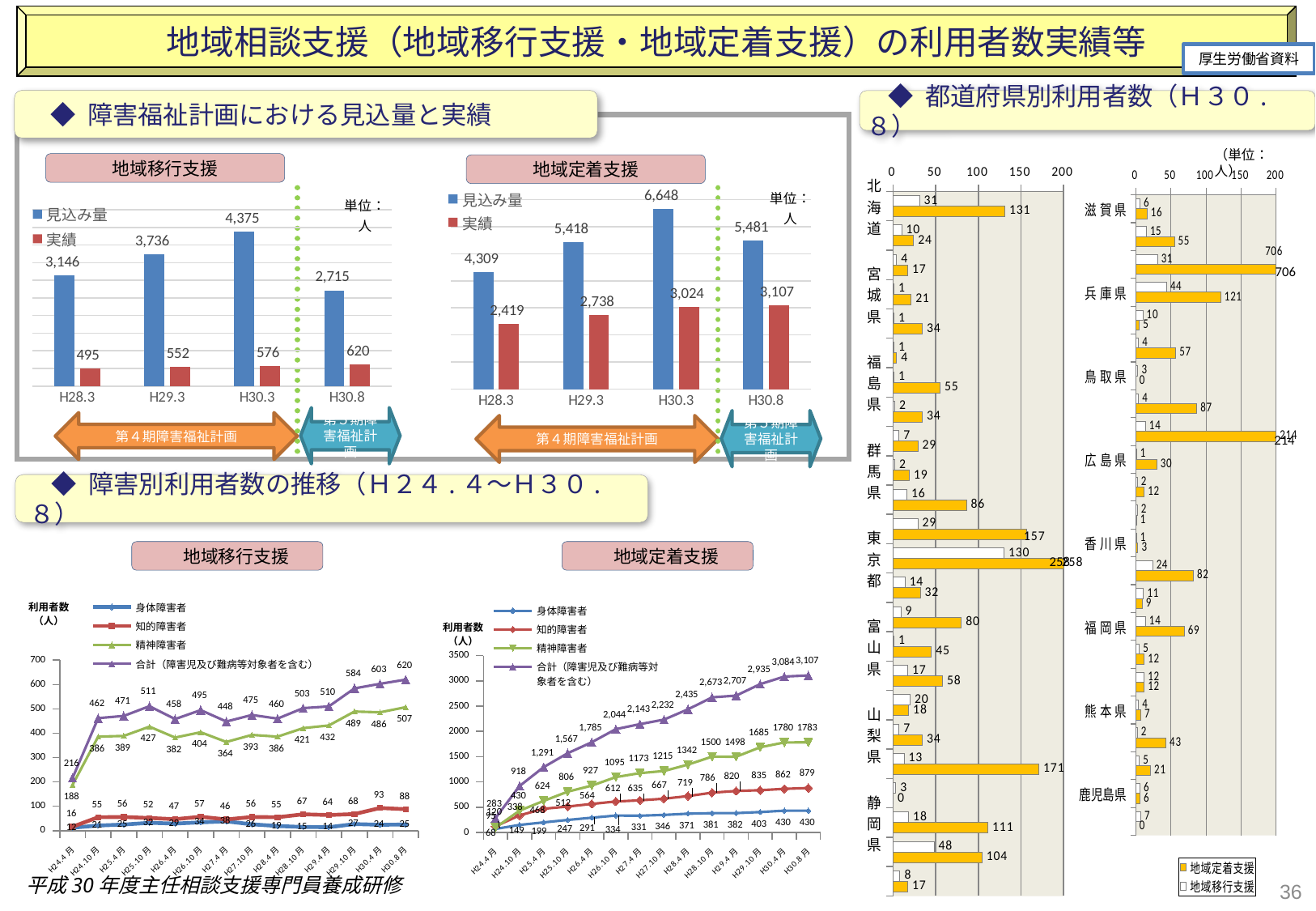
In the 都道府県別利用者数 chart on the right, how many series does the legend list? 2 In the 地域移行支援 line chart under 障害別利用者数の推移, what is the 合計 value at H30.8月? 620 In the 地域移行支援 bar chart under 障害福祉計画における見込み量と実績, what is the 見込み量 value for H30.3? 4,375 In the 地域移行支援 bar chart under 障害福祉計画における見込み量と実績, what is the 実績 value for H30.8? 620 In the 地域定着支援 line chart under 障害別利用者数の推移, what is the 合計 value at H30.8月? 3,107 In the 地域定着支援 bar chart under 障害福祉計画における見込み量と実績, what is the difference between 見込み量 and 実績 for H28.3? 1,890 In the 地域定着支援 bar chart under 障害福祉計画における見込み量と実績, what is the 見込み量 value for H30.3? 6,648 What kind of chart is the 地域移行支援 chart under 障害福祉計画における見込み量と実績? Bar chart In the 地域定着支援 bar chart under 障害福祉計画における見込み量と実績, which period has the highest 見込み量? H30.3 In the 地域移行支援 bar chart under 障害福祉計画における見込み量と実績, how many periods are shown on the x axis? 4 In the 地域定着支援 line chart under 障害別利用者数の推移, does the 合計 series rise or fall from H24.4月 to H30.8月? Rises In the 地域移行支援 line chart under 障害別利用者数の推移, how many series does the legend list? 4